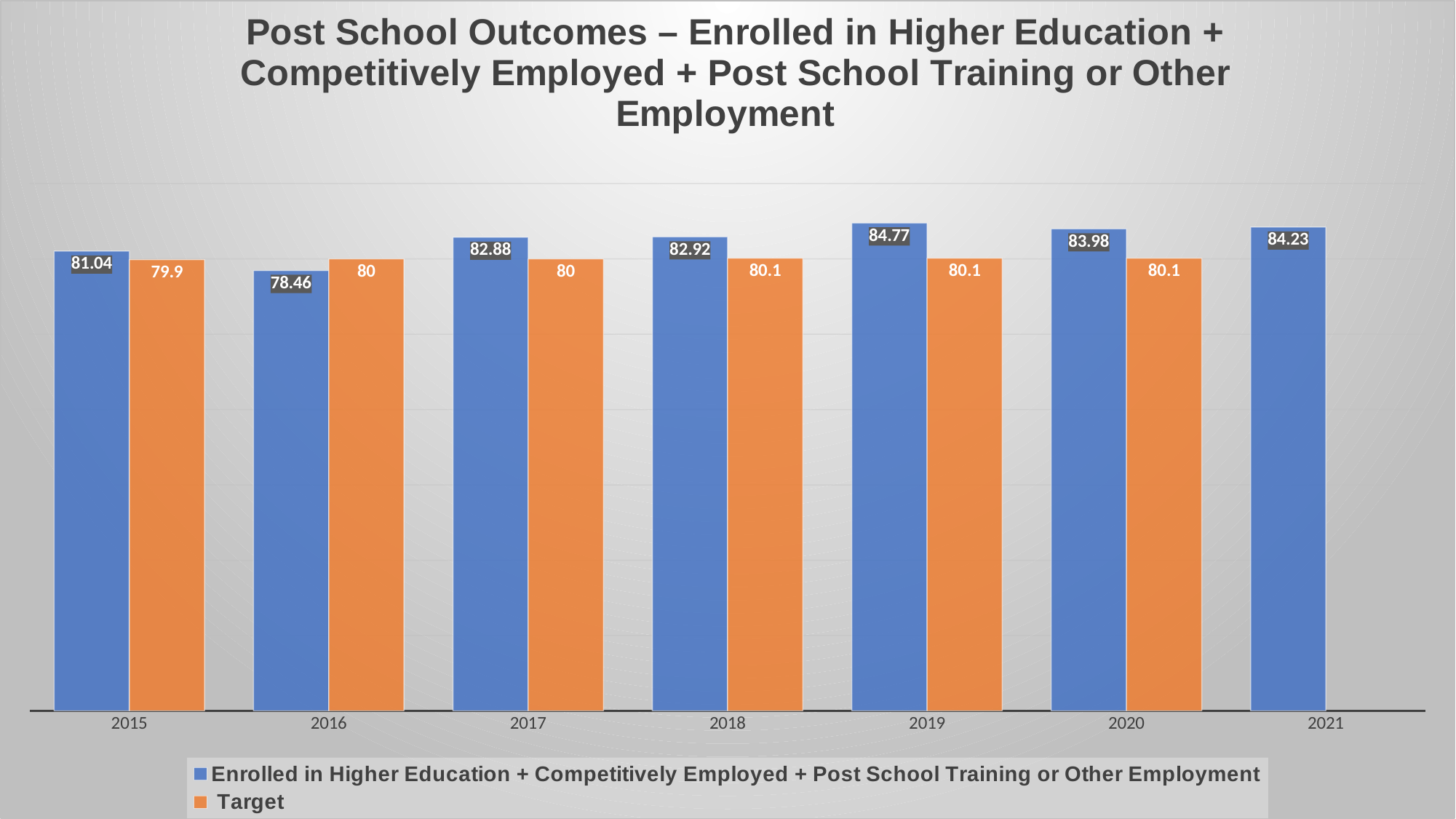
How many series does the legend list? 2 What kind of chart is this? Bar chart What is the Target value for 2015? 79.9 What is the value of the Enrolled in Higher Education + Competitively Employed + Post School Training or Other Employment series for 2019? 84.77 How many years are shown on the x axis? 7 What is the Target value for 2018? 80.1 Which year has the lowest value for the Enrolled in Higher Education + Competitively Employed + Post School Training or Other Employment series? 2016 Which year has no Target bar shown? 2021 What is the difference between the blue series value and the Target for 2019? 4.67 In 2016, which is larger: the blue series value or the Target? Target Which year has the highest value for the Enrolled in Higher Education + Competitively Employed + Post School Training or Other Employment series? 2019 What is the value of the blue series for 2016? 78.46